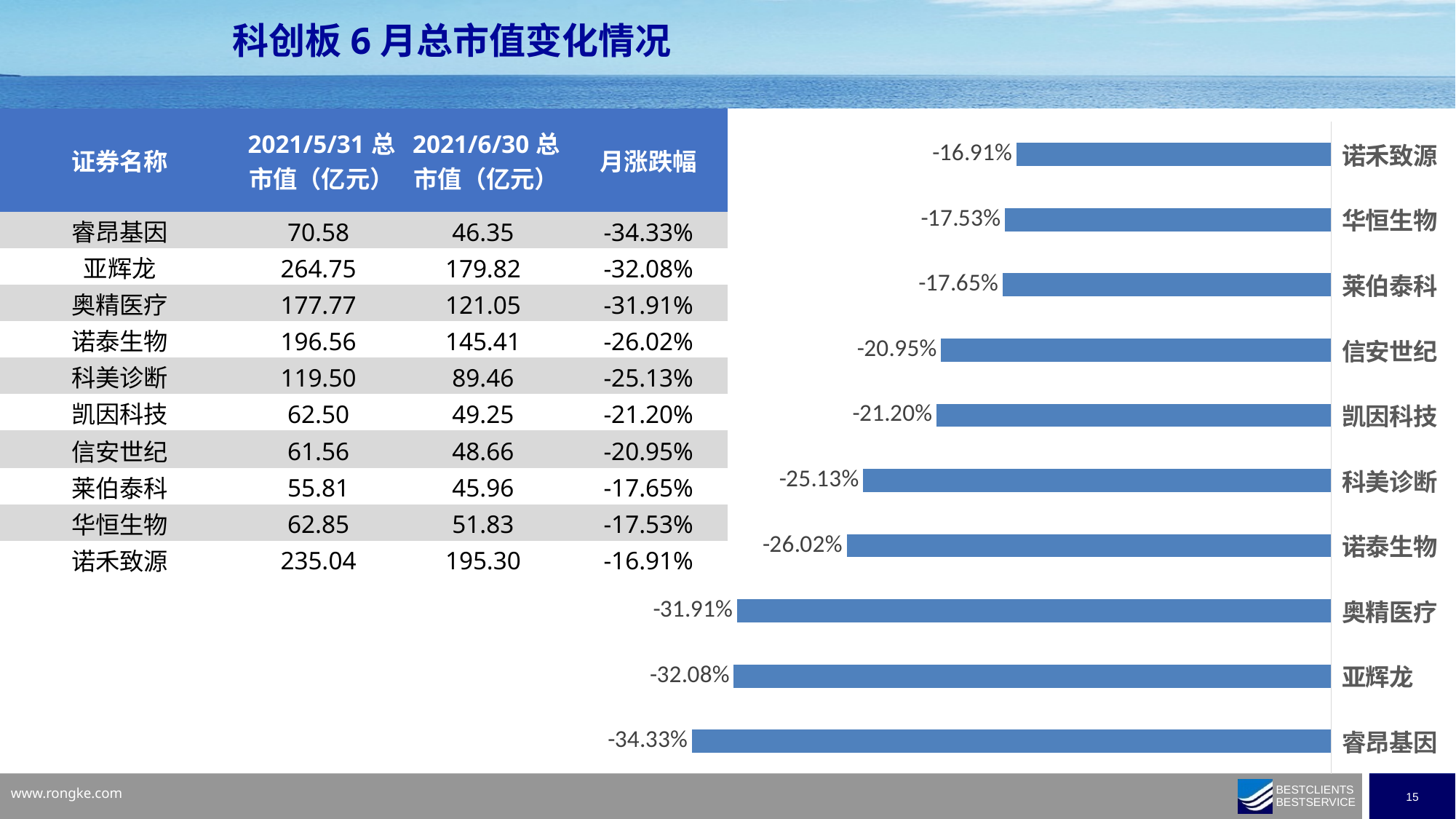
In the bar chart, what is the monthly change value shown for 信安世纪? -20.95% What kind of chart is shown on the right side of the slide? bar chart In the bar chart, what is the difference in percentage points between the values for 凯因科技 (-21.20%) and 信安世纪 (-20.95%)? 0.25 percentage points In the bar chart, what is the monthly change value shown for 诺禾致源? -16.91% Which company in the bar chart has the largest decline (the lowest value)? 睿昂基因 In the bar chart, what is the monthly change value shown for 亚辉龙? -32.08% How many companies are plotted in the bar chart? 10 Which company in the bar chart has the smallest decline (the highest value)? 诺禾致源 In the bar chart, what is the monthly change value shown for 科美诊断? -25.13% In the bar chart, what is the difference in percentage points between the values for 诺禾致源 (-16.91%) and 睿昂基因 (-34.33%)? 17.42 percentage points In the bar chart, which has the higher value, 科美诊断 or 诺泰生物? 科美诊断 What is the title of the slide containing the bar chart? 科创板 6 月总市值变化情况